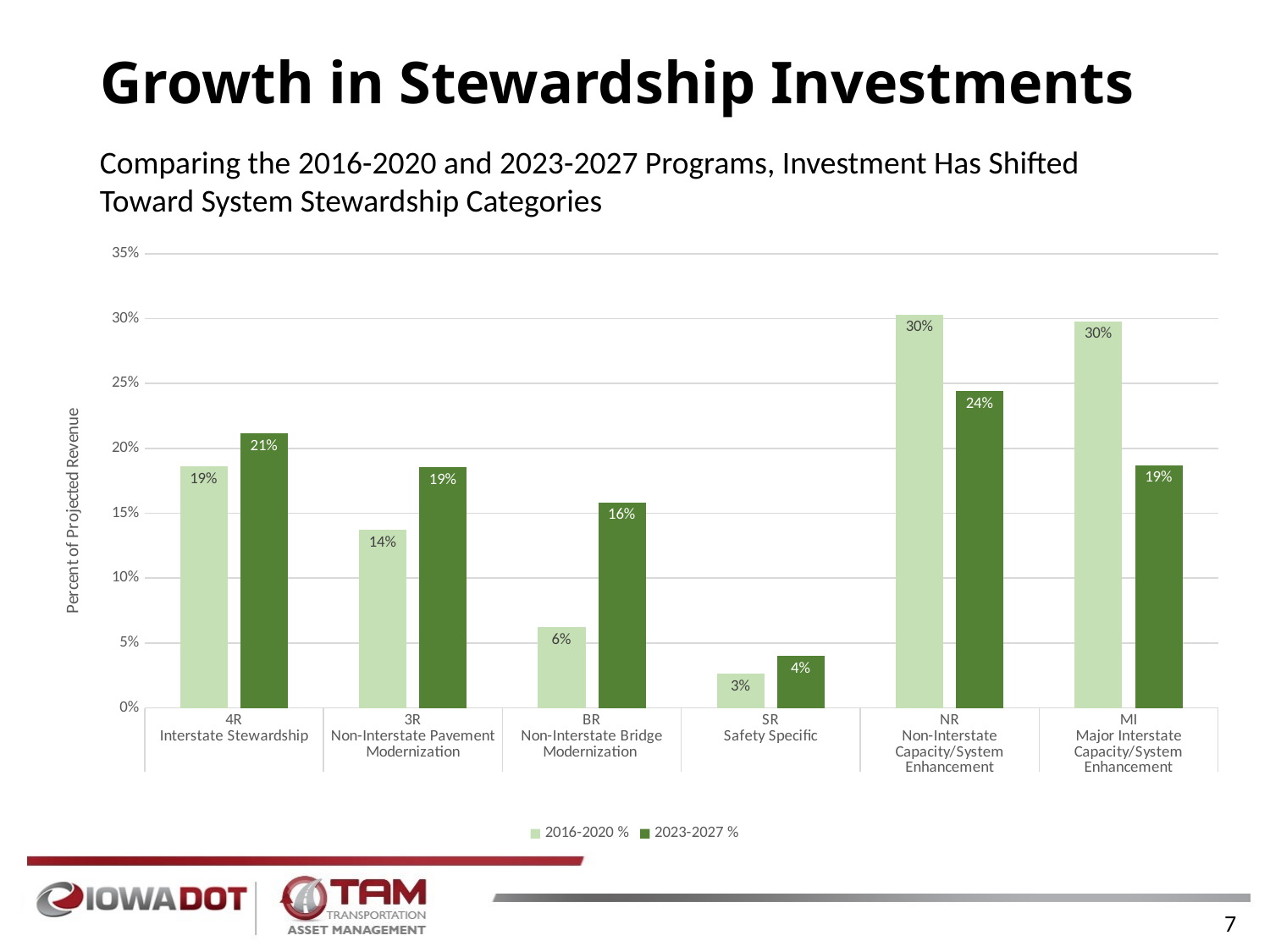
What is the 2023-2027 % value for BR Non-Interstate Bridge Modernization? 16% How many series does the chart's legend list? 2 Is the 2023-2027 % value for 3R Non-Interstate Pavement Modernization greater or less than 15%? greater How many categories are shown on the x axis of the chart? 6 What kind of chart is shown on the slide? Bar chart Which category has the highest 2023-2027 % value? NR Non-Interstate Capacity/System Enhancement What is the difference between the 2023-2027 % and 2016-2020 % values for BR Non-Interstate Bridge Modernization? 10 percentage points What is the 2016-2020 % value for 4R Interstate Stewardship? 19% Which category has the lowest 2016-2020 % value? SR Safety Specific What is the label of the chart's vertical axis? Percent of Projected Revenue What is the 2023-2027 % value for NR Non-Interstate Capacity/System Enhancement? 24% For MI Major Interstate Capacity/System Enhancement, which is larger: the 2016-2020 % value or the 2023-2027 % value? 2016-2020 %